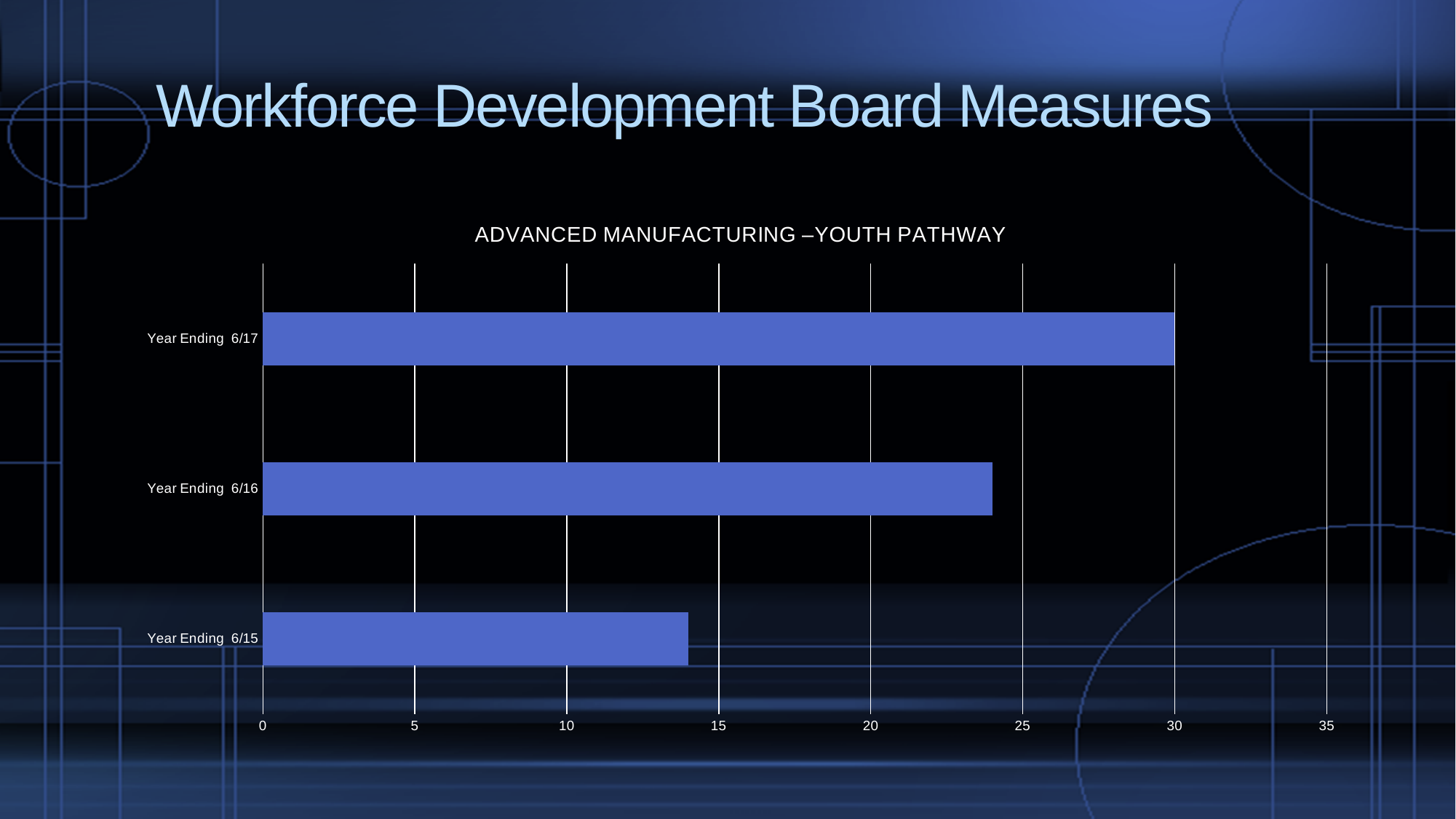
Is the value for Year Ending 6/16 greater or less than 20? greater Is the value for Year Ending 6/15 greater or less than 10? greater Is the value for Year Ending 6/15 greater or less than 15? less What is the title of the chart? ADVANCED MANUFACTURING –YOUTH PATHWAY Do the values rise or fall from Year Ending 6/15 to Year Ending 6/17? rise Which is larger, the value for Year Ending 6/16 or Year Ending 6/15? Year Ending 6/16 Which category has the lowest value? Year Ending 6/15 What kind of chart is shown on the slide? bar chart What is the value for Year Ending 6/17? 30 Which category has the highest value? Year Ending 6/17 How many categories are plotted in the chart? 3